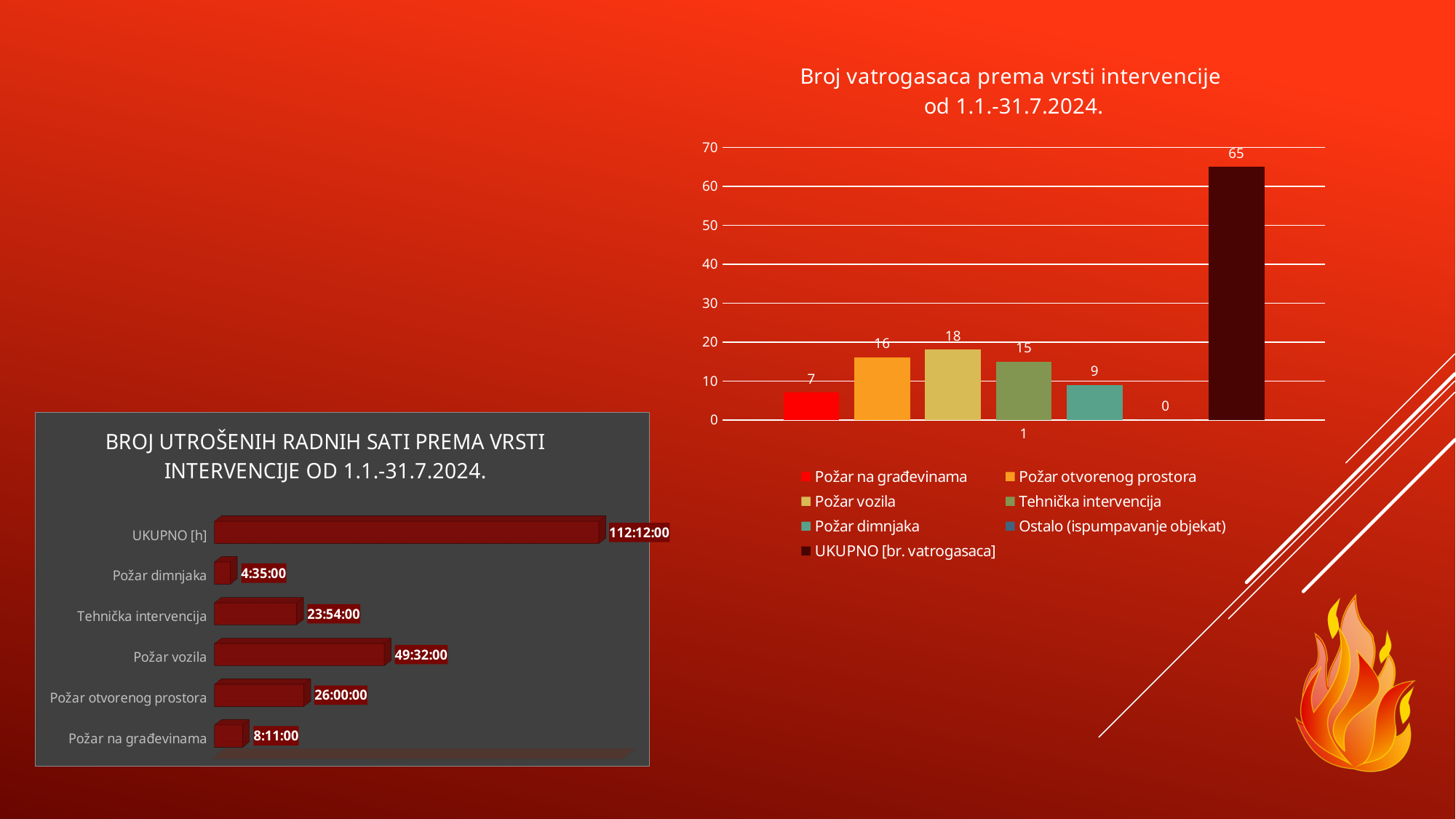
On the chart 'Broj vatrogasaca prema vrsti intervencije', what colour is the bar for Požar otvorenog prostora? Orange On the chart 'Broj vatrogasaca prema vrsti intervencije', which series has the highest value? UKUPNO [br. vatrogasaca] On the chart 'BROJ UTROŠENIH RADNIH SATI PREMA VRSTI INTERVENCIJE', how many categories are shown? 6 On the chart 'Broj vatrogasaca prema vrsti intervencije', what is the value for Požar vozila? 18 On the chart 'Broj vatrogasaca prema vrsti intervencije', what is the difference between Požar otvorenog prostora and Požar na građevinama? 9 On the chart 'BROJ UTROŠENIH RADNIH SATI PREMA VRSTI INTERVENCIJE', which category has the lowest value? Požar dimnjaka On the chart 'Broj vatrogasaca prema vrsti intervencije', what is the value for Ostalo (ispumpavanje objekat)? 0 On the chart 'Broj vatrogasaca prema vrsti intervencije', how many series does the legend list? 7 On the chart 'Broj vatrogasaca prema vrsti intervencije', which is larger: Tehnička intervencija or Požar dimnjaka? Tehnička intervencija On the chart 'BROJ UTROŠENIH RADNIH SATI PREMA VRSTI INTERVENCIJE', what is the value for UKUPNO [h]? 112:12:00 On the chart 'BROJ UTROŠENIH RADNIH SATI PREMA VRSTI INTERVENCIJE', what is the value for Požar vozila? 49:32:00 What kind of chart is the one on the left of the slide? Bar chart